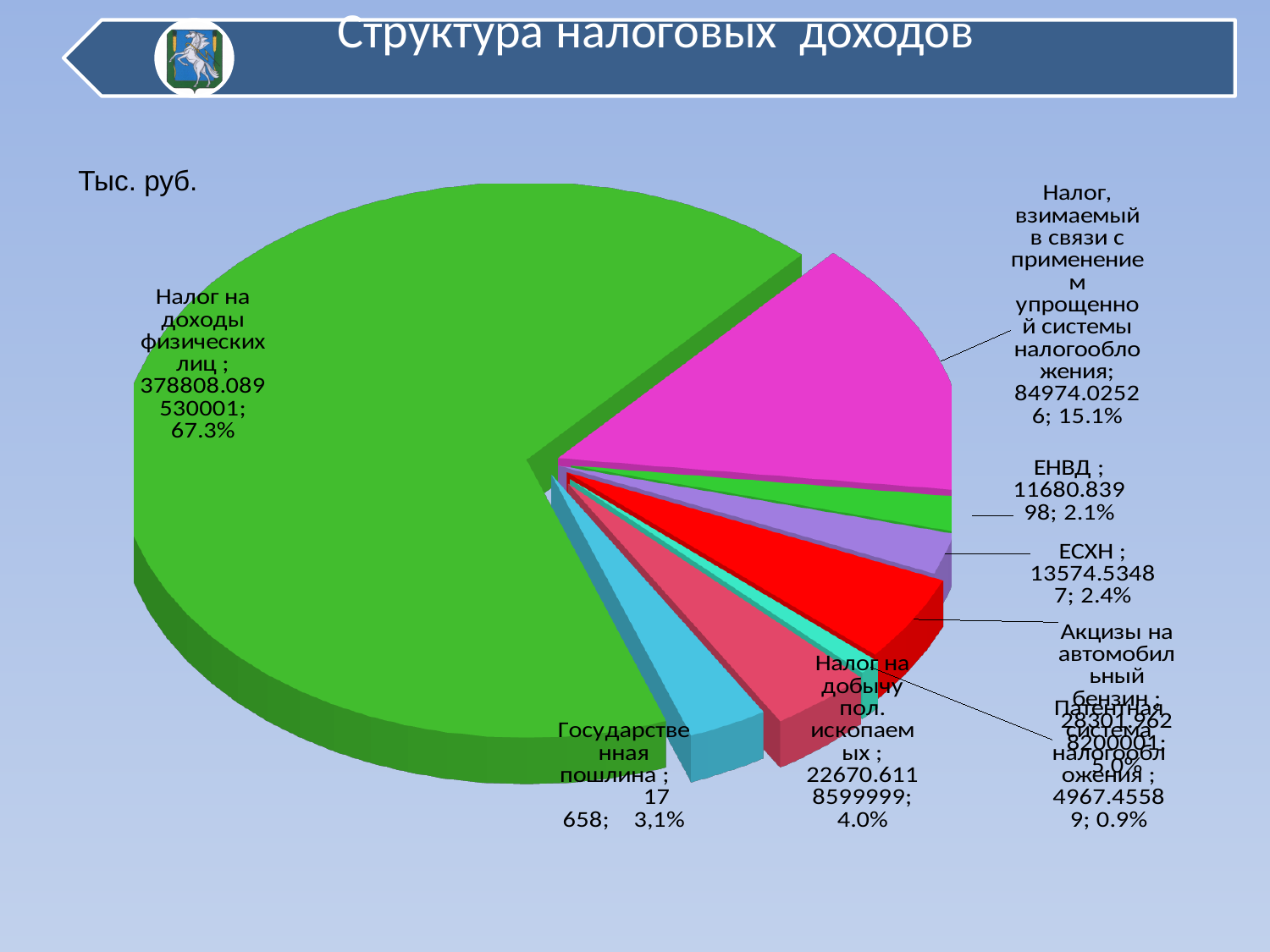
Which is larger: the share for ЕСХН or the share for ЕНВД? ЕСХН What share of the pie does Налог на добычу пол. ископаемых represent? 4.0% What share of the pie does Государственная пошлина represent? 3,1% How many slices does the pie chart have? 8 What is the title of the chart on the slide? Структура налоговых доходов What share of the pie does Налог на доходы физических лиц represent? 67.3% What kind of chart is shown on the slide? pie chart Which slice of the pie is the largest? Налог на доходы физических лиц Which slice of the pie is the smallest? Патентная система налогообложения